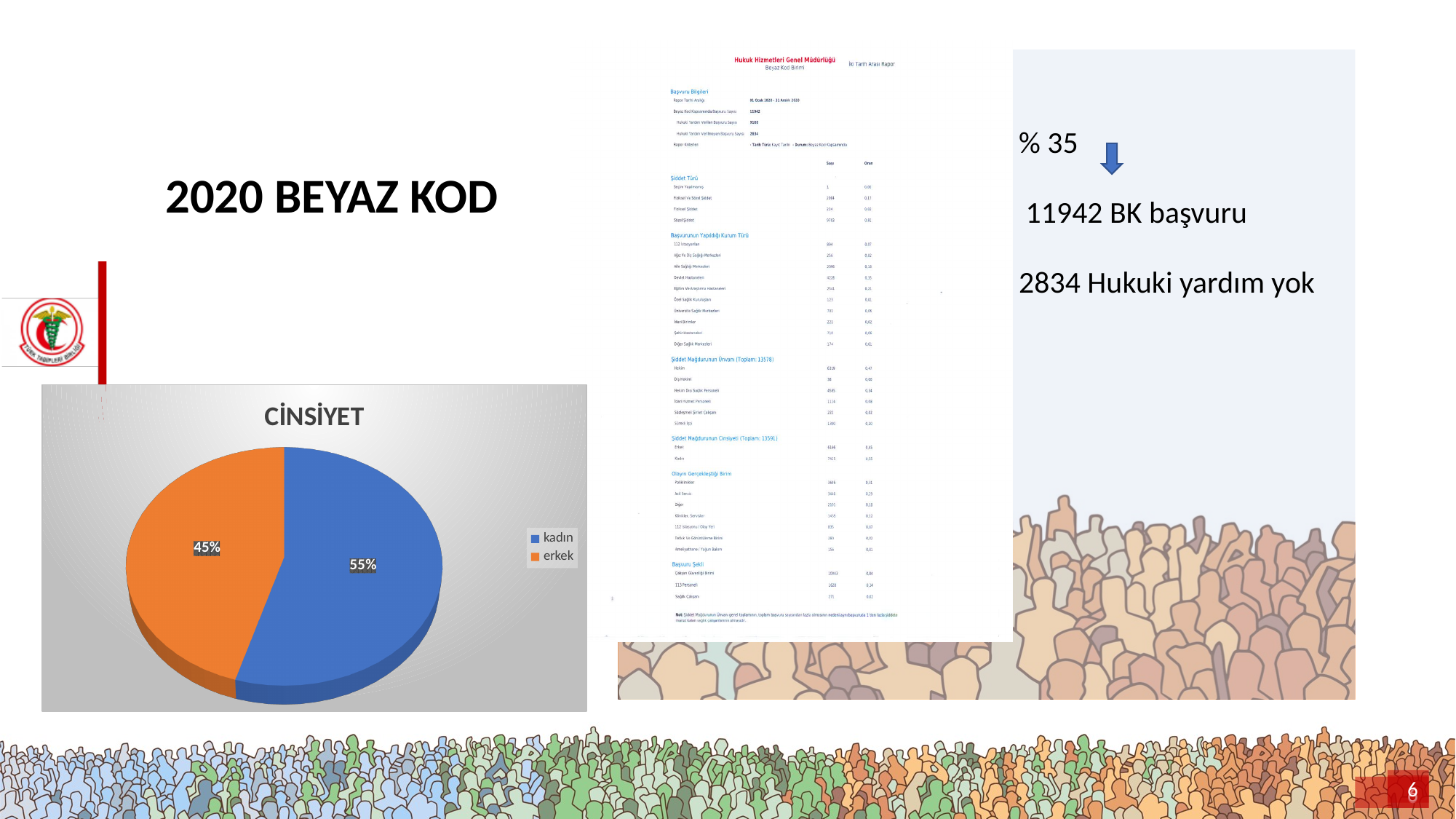
What kind of chart is shown under the title CİNSİYET? pie chart How many entries does the legend of the pie chart list? 2 What share of the pie chart does kadın represent? 55% What is the title of the pie chart? CİNSİYET How many categories does the pie chart show? 2 Which is larger in the pie chart, kadın or erkek? kadın Is the share for erkek greater or less than 50%? less What share of the pie chart does erkek represent? 45% What is the difference in percentage points between the kadın and erkek slices? 10% Which colour represents erkek in the pie chart? orange Which category has the smallest slice in the pie chart? erkek Which category has the largest slice in the pie chart? kadın